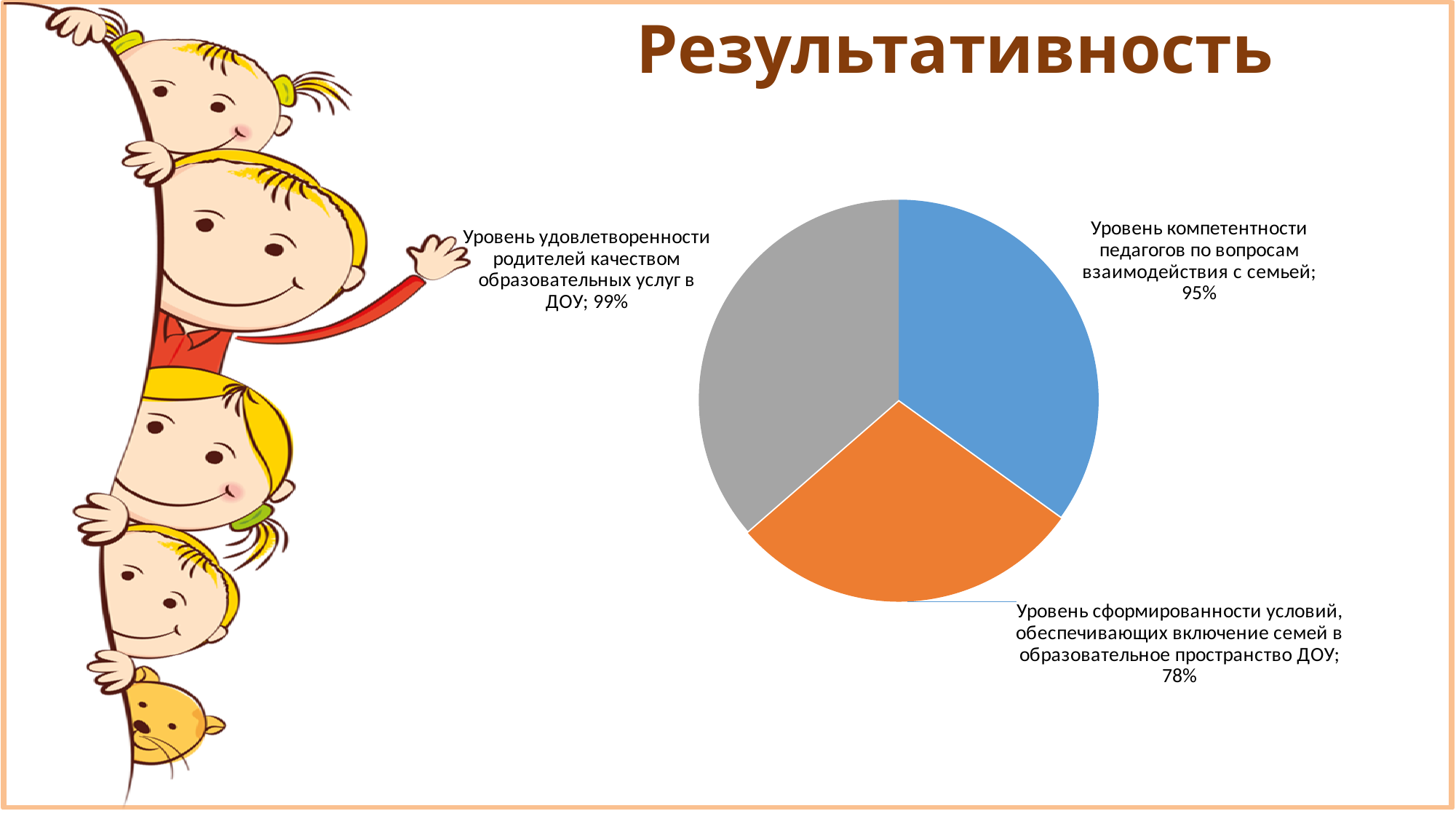
What is the title of the slide containing the pie chart? Результативность What type of chart is shown on the slide? Pie chart What is the value shown for "Уровень компетентности педагогов по вопросам взаимодействия с семьей"? 95% What is the value shown for "Уровень удовлетворенности родителей качеством образовательных услуг в ДОУ"? 99% How many slices does the pie chart have? 3 Which category has the highest value in the pie chart? Уровень удовлетворенности родителей качеством образовательных услуг в ДОУ Which category has the lowest value in the pie chart? Уровень сформированности условий, обеспечивающих включение семей в образовательное пространство ДОУ Which is larger: the value for "Уровень компетентности педагогов" or the value for "Уровень сформированности условий"? Уровень компетентности педагогов What is the difference between the value for parents' satisfaction (Уровень удовлетворенности родителей) and the value for the conditions for including families (Уровень сформированности условий)? 21 percentage points What is the value shown for "Уровень сформированности условий, обеспечивающих включение семей в образовательное пространство ДОУ"? 78% What is the difference between the value for parents' satisfaction (99%) and the value for teachers' competence (95%)? 4 percentage points What colour is the slice labelled 95%? Blue